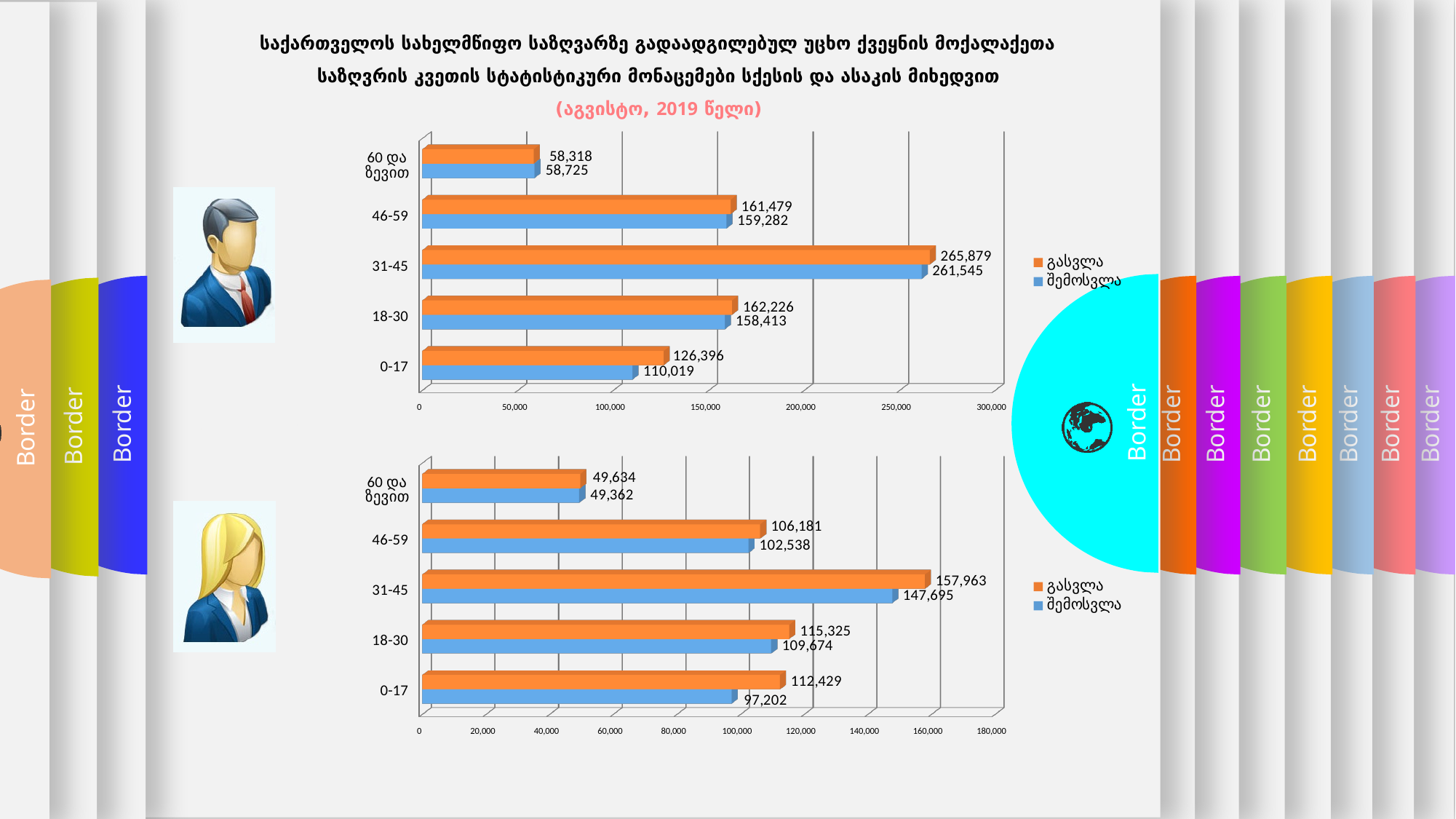
In the bottom chart, what is the გასვლა value for the 18-30 age group? 115,325 In the bottom chart, what is the difference between the გასვლა and შემოსვლა values for the 31-45 age group? 10,268 In the bottom chart, which age group has the lowest შემოსვლა value? 60 და ზევით In the top chart, what is the difference between the გასვლა and შემოსვლა values for the 0-17 age group? 16,377 In the bottom chart, what is the შემოსვლა value for the 46-59 age group? 102,538 In the top chart, what is the გასვლა value for the 31-45 age group? 265,879 In the top chart, which age group has the highest გასვლა value? 31-45 In the top chart, what is the შემოსვლა value for the 0-17 age group? 110,019 How many series does the legend of the bottom chart list? 2 In the bottom chart, which is larger for the 0-17 age group: გასვლა or შემოსვლა? გასვლა What type of chart is the top chart? Bar chart How many age groups are shown in the top chart? 5